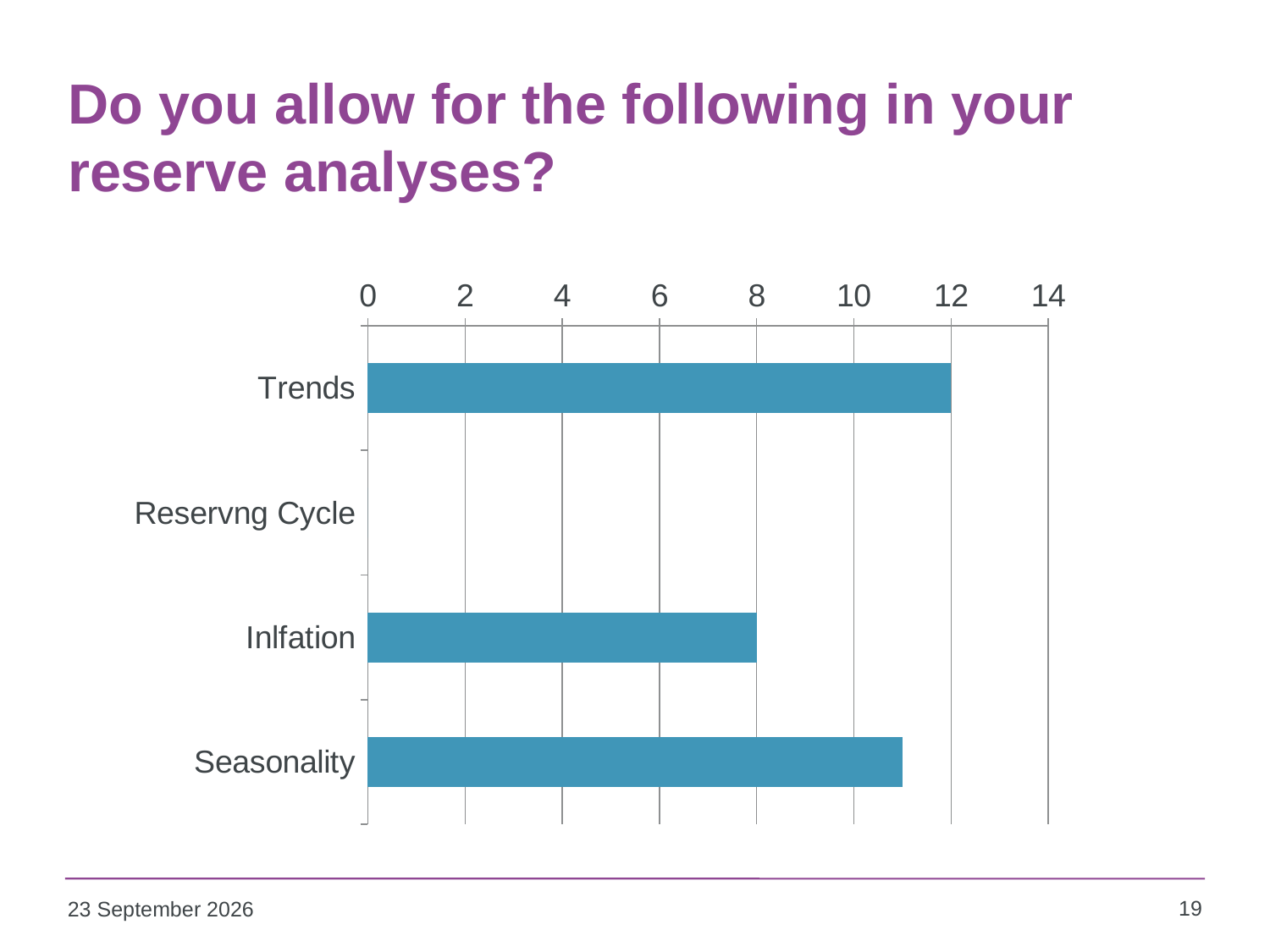
What is the title of the slide containing the chart? Do you allow for the following in your reserve analyses? What kind of chart is shown on the slide? bar chart What is the value for Trends? 12 Is the value for Seasonality greater or less than 12? less How many categories are shown in the chart? 4 Which is larger, the value for Trends or the value for Seasonality? Trends Is the value for Seasonality greater or less than 10? greater Which category has the lowest value? Reservng Cycle Which is larger, the value for Seasonality or the value for Inlfation? Seasonality What is the difference between the values for Trends and Inlfation? 4 Which category has the highest value? Trends What is the value for Inlfation? 8